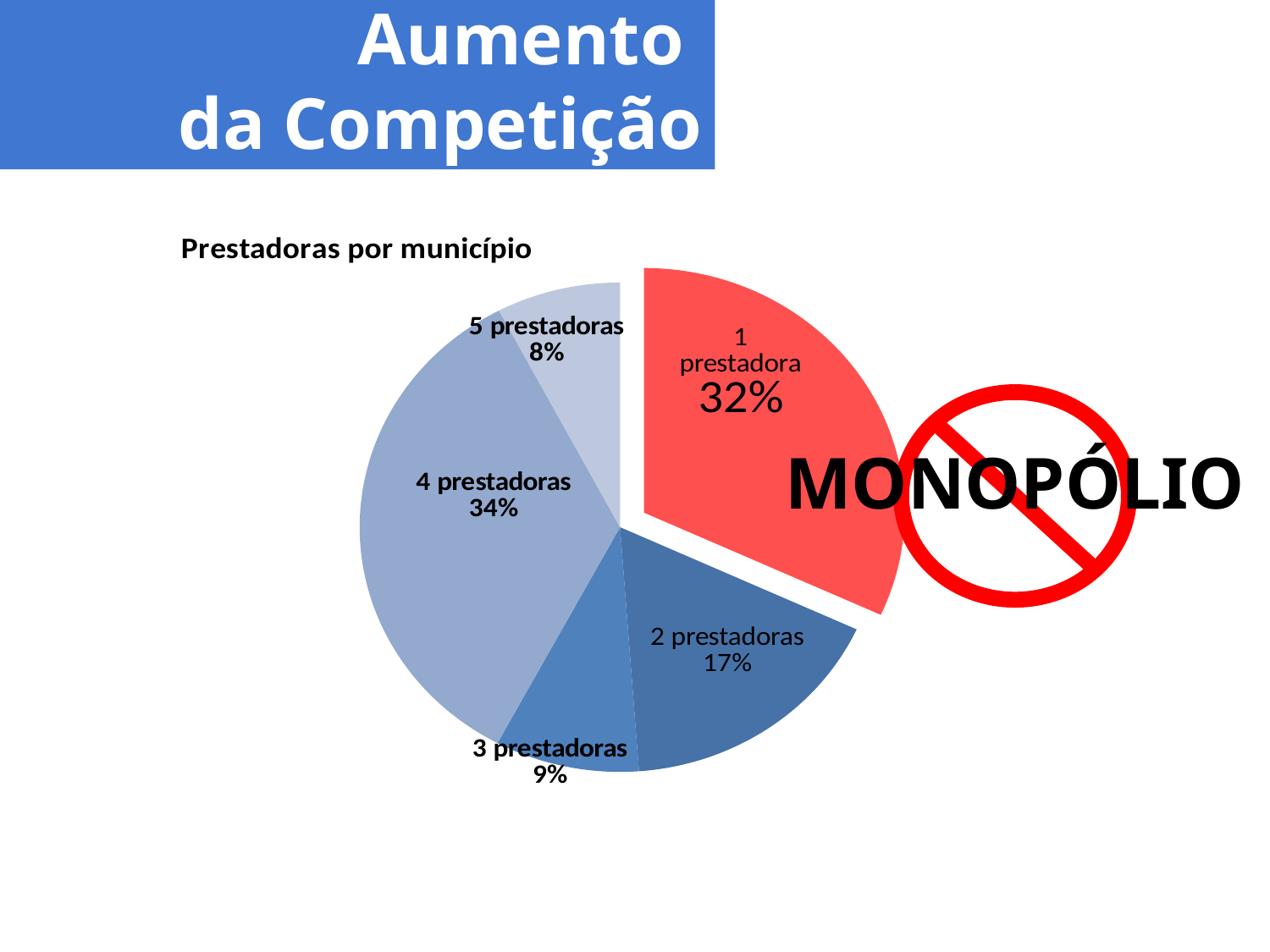
What type of chart is shown on the slide? Pie chart What is the title of the chart? Prestadoras por município What is the difference between the shares for '1 prestadora' and '2 prestadoras'? 15% What share of the pie does the '1 prestadora' slice represent? 32% What is the value shown for '2 prestadoras'? 17% Which is larger, the share for '3 prestadoras' or the share for '5 prestadoras'? 3 prestadoras Which category has the largest slice of the pie? 4 prestadoras What is the value shown for '4 prestadoras'? 34% What is the value shown for '5 prestadoras'? 8% Which category has the smallest slice of the pie? 5 prestadoras How many slices does the pie chart have? 5 What is the value shown for '3 prestadoras'? 9%